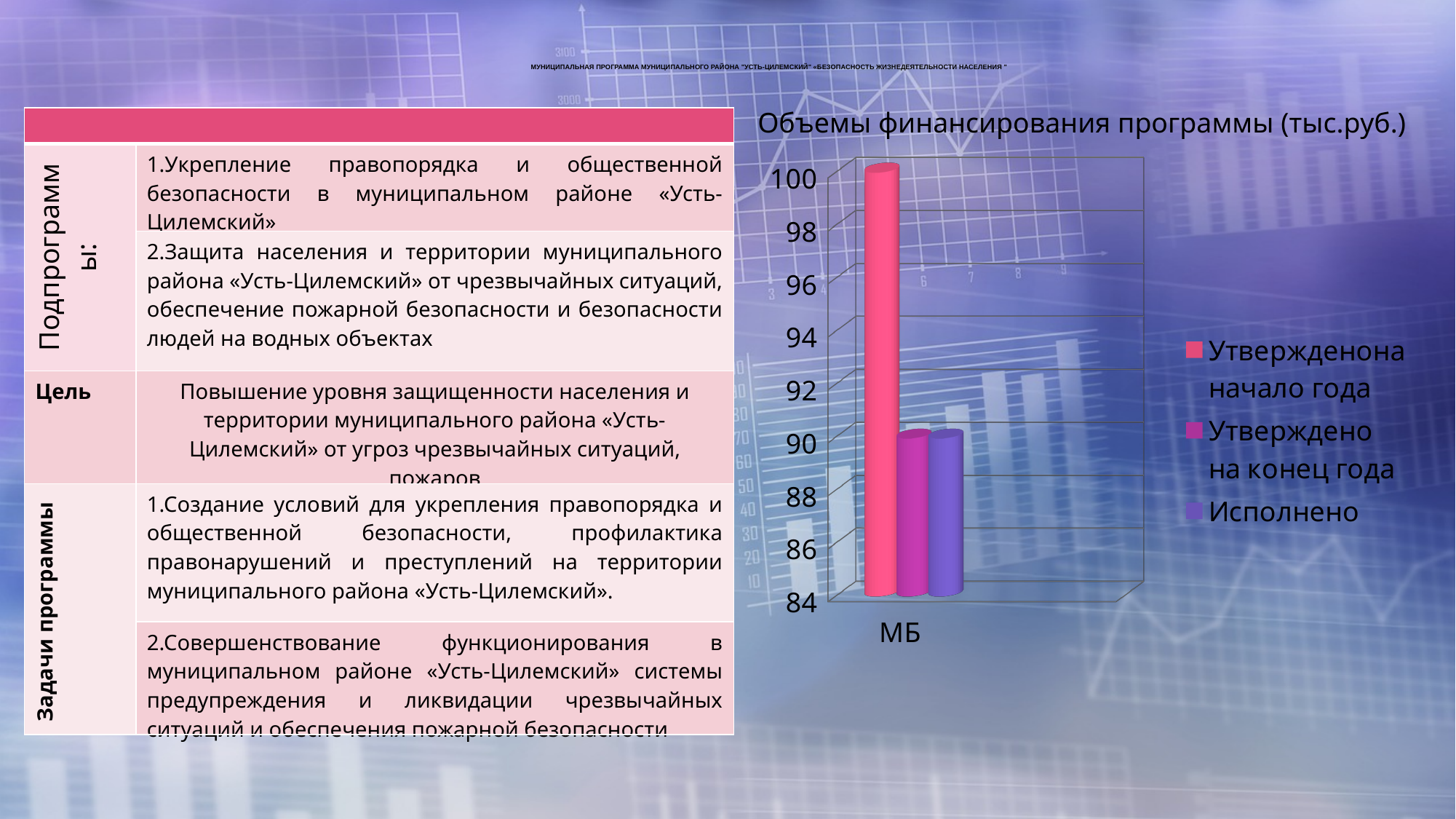
Which is larger for МБ: Утвержденона начало года or Утверждено на конец года? Утвержденона начало года Is the value for Исполнено greater or less than 94? less Is the value for Утверждено на конец года greater or less than 92? less What is the title of the chart? Объемы финансирования программы (тыс.руб.) Is the value for Исполнено greater or less than 88? greater Which is larger for МБ: Исполнено or Утвержденона начало года? Утвержденона начало года How many categories are shown on the x axis of the chart? 1 Which series has the highest value for МБ? Утвержденона начало года How many series does the chart legend list? 3 What kind of chart is shown on the slide? bar chart What is the category label on the x axis of the chart? МБ